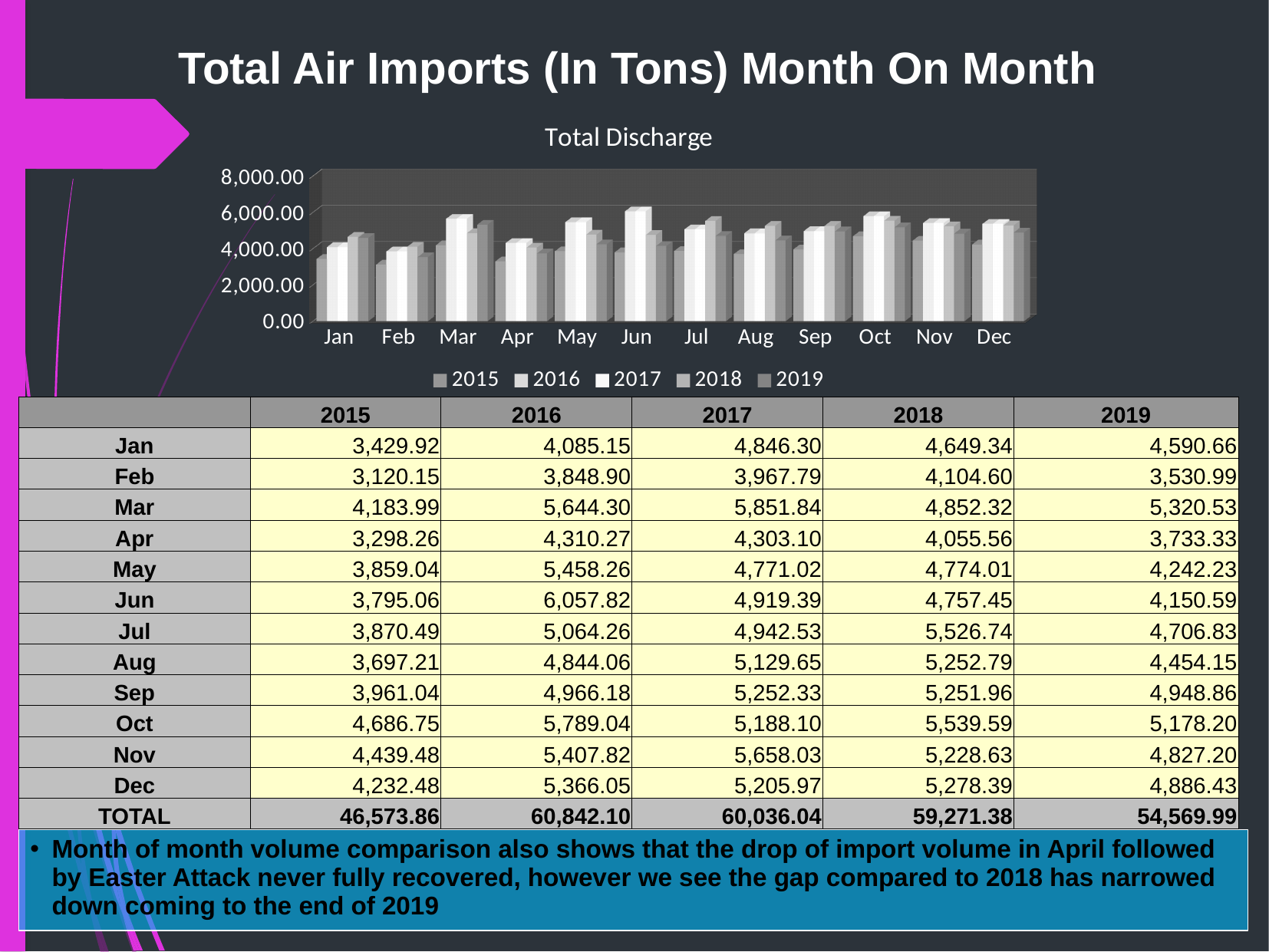
How many months are shown along the x axis of the Total Discharge chart? 12 Which month has the lowest value in the 2015 series? Feb What is the difference between the Jan values for 2018 and 2019? 58.68 For Mar, which series has the larger value, 2016 or 2017? 2017 What is the value for Jun in the 2016 series? 6,057.82 Which month has the highest value in the 2016 series? Jun What is the title of the chart? Total Discharge How many series does the legend of the Total Discharge chart list? 5 What is the value for Jul in the 2018 series? 5,526.74 In the 2015 series, do the values rise or fall from Aug to Oct? rise Is the value for Feb in the 2015 series greater or less than 4,000.00? less What kind of chart is shown on the slide? bar chart